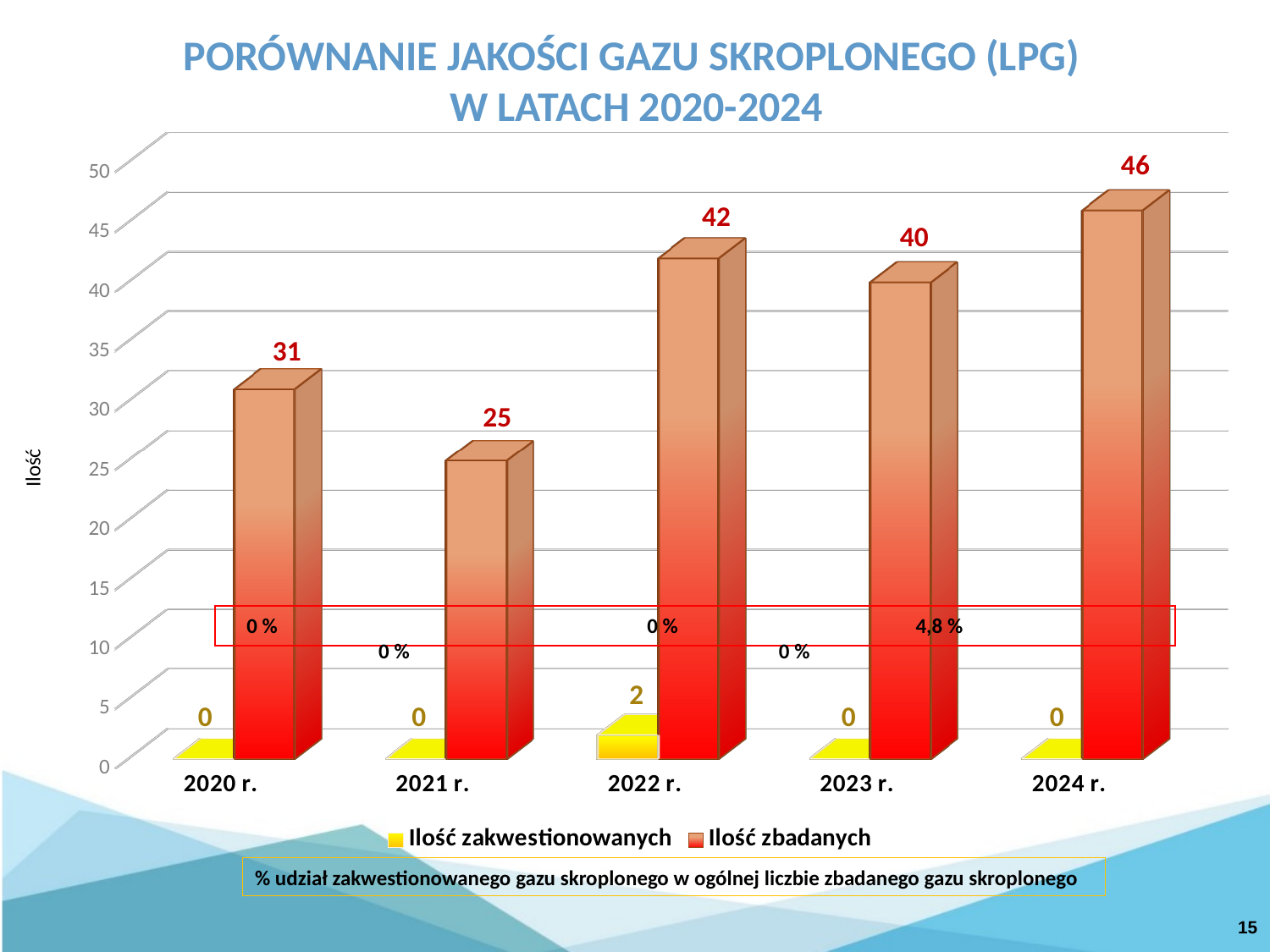
How many years are shown on the x axis? 5 What is the value of "Ilość zakwestionowanych" for 2022 r.? 2 What is the value of "Ilość zbadanych" for 2021 r.? 25 How many series does the legend list? 2 Which year has the highest value of "Ilość zbadanych"? 2024 r. Which is larger, "Ilość zbadanych" in 2022 r. or in 2023 r.? 2022 r. What is the value of "Ilość zbadanych" for 2024 r.? 46 Which year has the lowest value of "Ilość zbadanych"? 2021 r. Which year is the only one with a non-zero value of "Ilość zakwestionowanych"? 2022 r. What kind of chart is shown on the slide? Bar chart What is the label of the y axis? Ilość What is the difference between "Ilość zbadanych" in 2022 r. and 2021 r.? 17